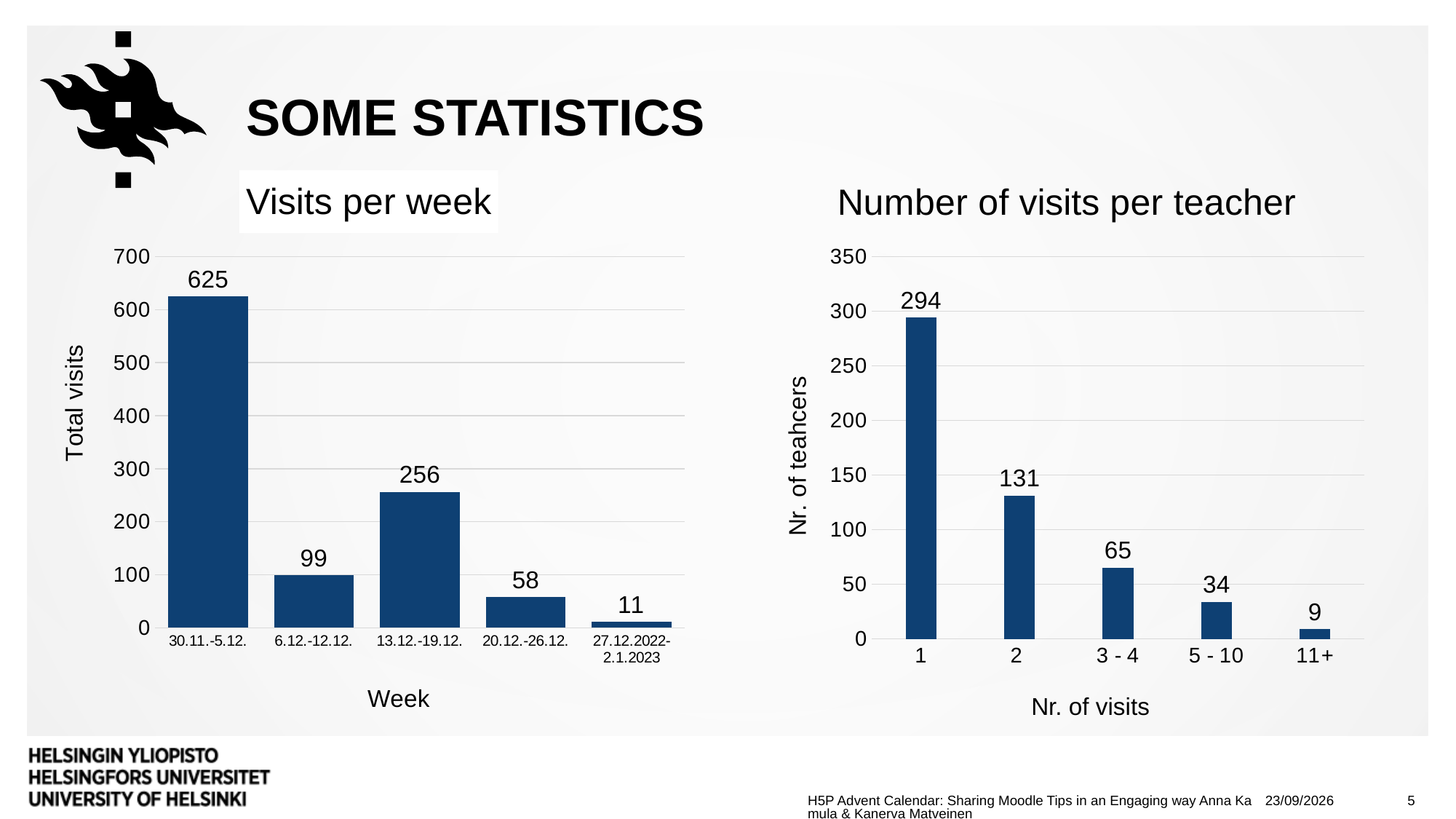
In the 'Number of visits per teacher' chart, what is the difference between the values for 3 - 4 and 5 - 10? 31 How many weeks are shown in the 'Visits per week' chart? 5 What is the y-axis label of the 'Visits per week' chart? Total visits In the 'Visits per week' chart, what is the value for the week 30.11.-5.12.? 625 What kind of chart is the 'Visits per week' chart? Bar chart In the 'Visits per week' chart, which week has the lowest total visits? 27.12.2022-2.1.2023 In the 'Number of visits per teacher' chart, how many teachers made 2 visits? 131 In the 'Number of visits per teacher' chart, what is the value for the 11+ category? 9 In the 'Visits per week' chart, what is the value for the week 13.12.-19.12.? 256 In the 'Number of visits per teacher' chart, which category has the highest number of teachers? 1 In the 'Visits per week' chart, which is larger: the value for 6.12.-12.12. or the value for 20.12.-26.12.? 6.12.-12.12. In the 'Visits per week' chart, what is the difference between the visits for 30.11.-5.12. and 13.12.-19.12.? 369